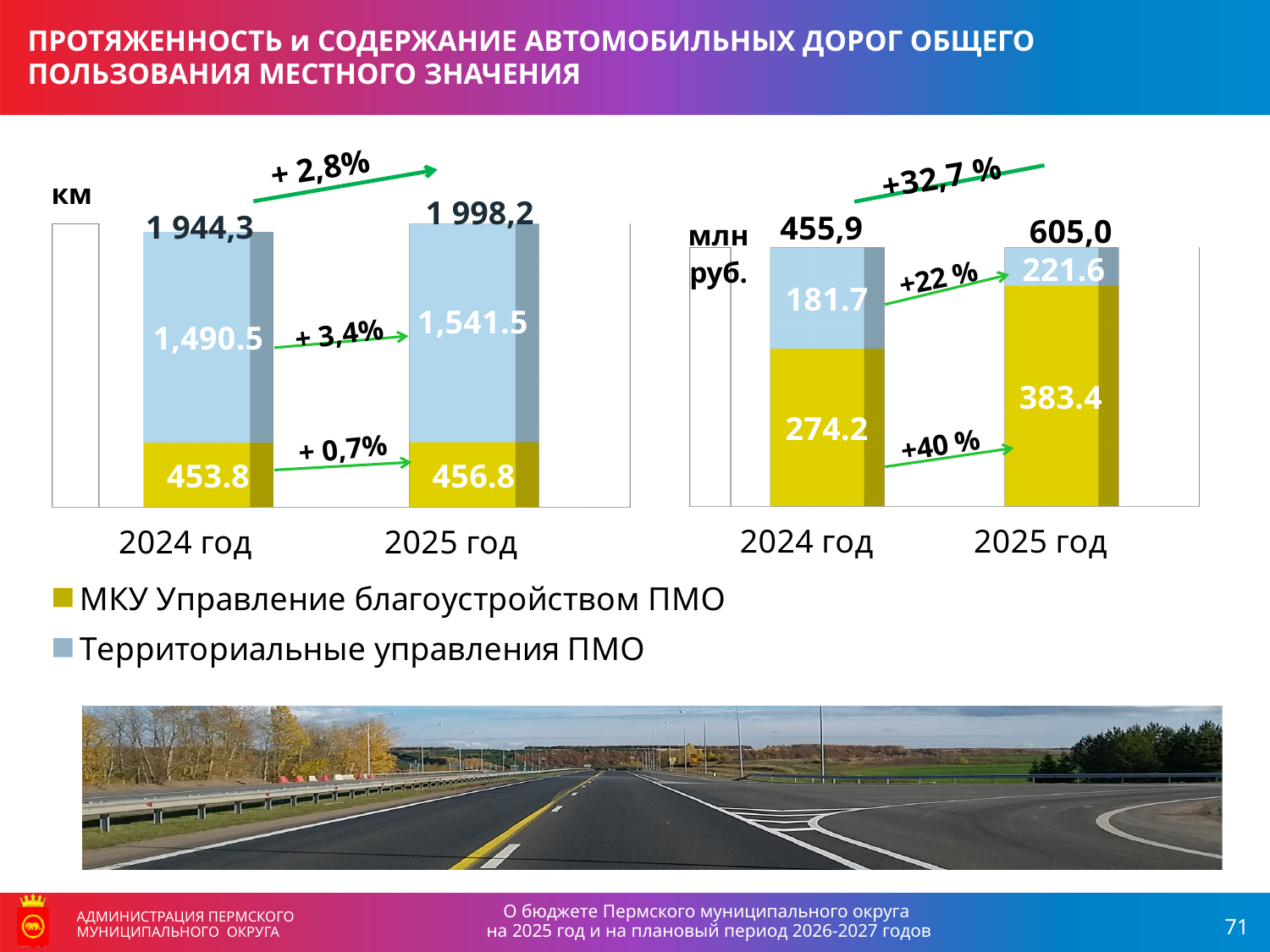
In the right chart (млн руб.), what is the value for МКУ Управление благоустройством ПМО in 2025 год? 383.4 In the right chart (млн руб.), which year has the higher total? 2025 год In the left chart (км), does the total rise or fall from 2024 год to 2025 год? Rise What kind of chart is the left chart (км)? Stacked bar chart In the left chart (км), what is the value for Территориальные управления ПМО in 2025 год? 1,541.5 In the left chart (км), what is the value for МКУ Управление благоустройством ПМО in 2024 год? 453.8 In the left chart (км), which is larger in 2024 год: МКУ Управление благоустройством ПМО or Территориальные управления ПМО? Территориальные управления ПМО In the right chart (млн руб.), what is the total of the stacked bar for 2024 год? 455,9 In the left chart (км), what is the total of the stacked bar for 2025 год? 1 998,2 How many series does the legend list? 2 In the right chart (млн руб.), what is the value for Территориальные управления ПМО in 2024 год? 181.7 In the right chart (млн руб.), what is the difference between the МКУ Управление благоустройством ПМО values for 2025 год and 2024 год? 109.2